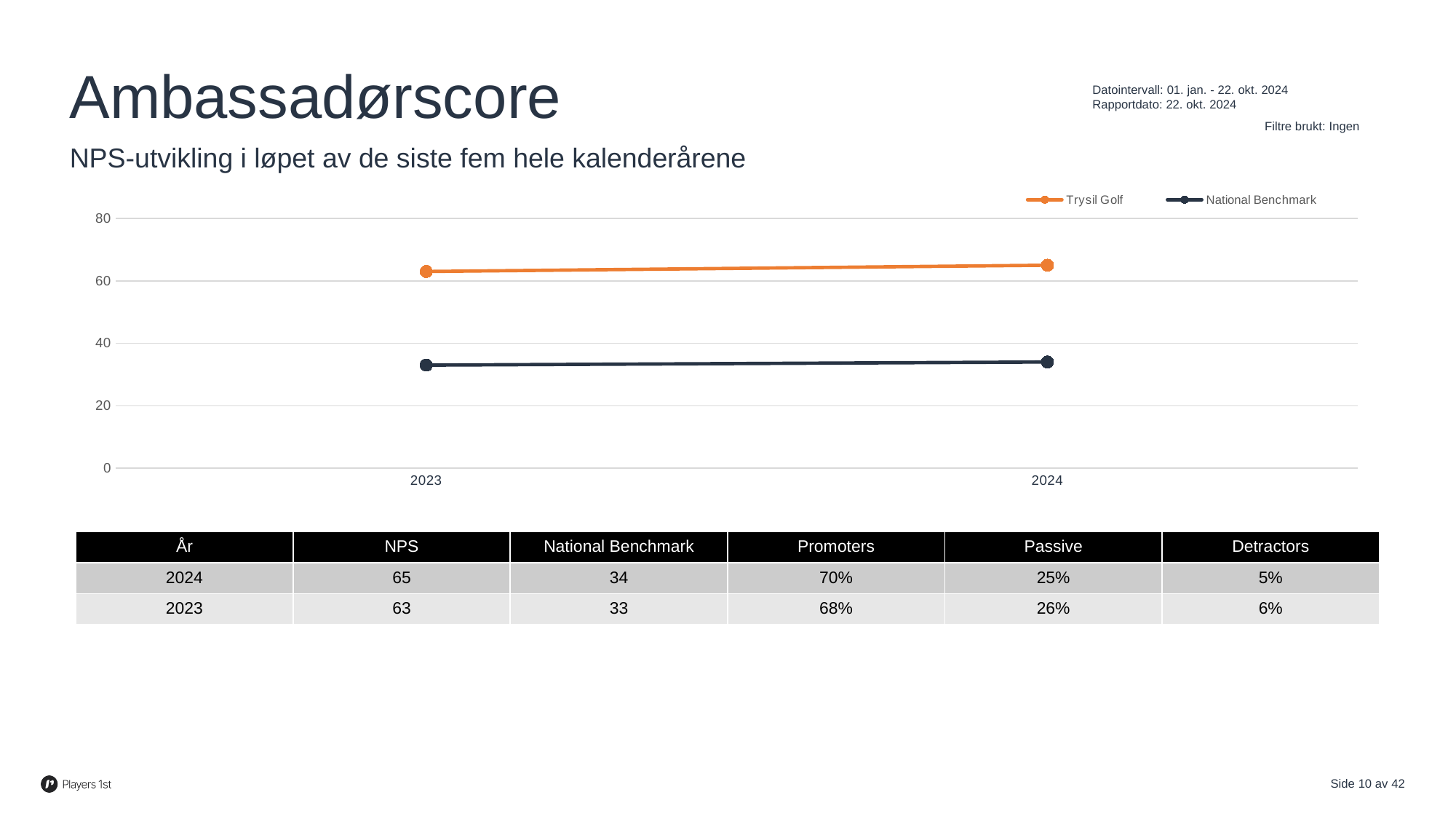
How many series does the chart legend list? 2 What is the subtitle of the chart on the slide? NPS-utvikling i løpet av de siste fem hele kalenderårene According to the table below the chart, what is the NPS for 2024? 65 Which series is shown in orange in the chart? Trysil Golf According to the table below the chart, what is the National Benchmark for 2023? 33 Which series has the higher value in 2024, Trysil Golf or National Benchmark? Trysil Golf Using the values in the table, what is the difference between the NPS and the National Benchmark in 2024? 31 How many years are plotted on the x axis of the chart? 2 Does the Trysil Golf line rise or fall from 2023 to 2024? rise What kind of chart is shown on the slide? line chart Is the value for National Benchmark in 2023 greater or less than 40? less Is the value for Trysil Golf in 2024 greater or less than 60? greater